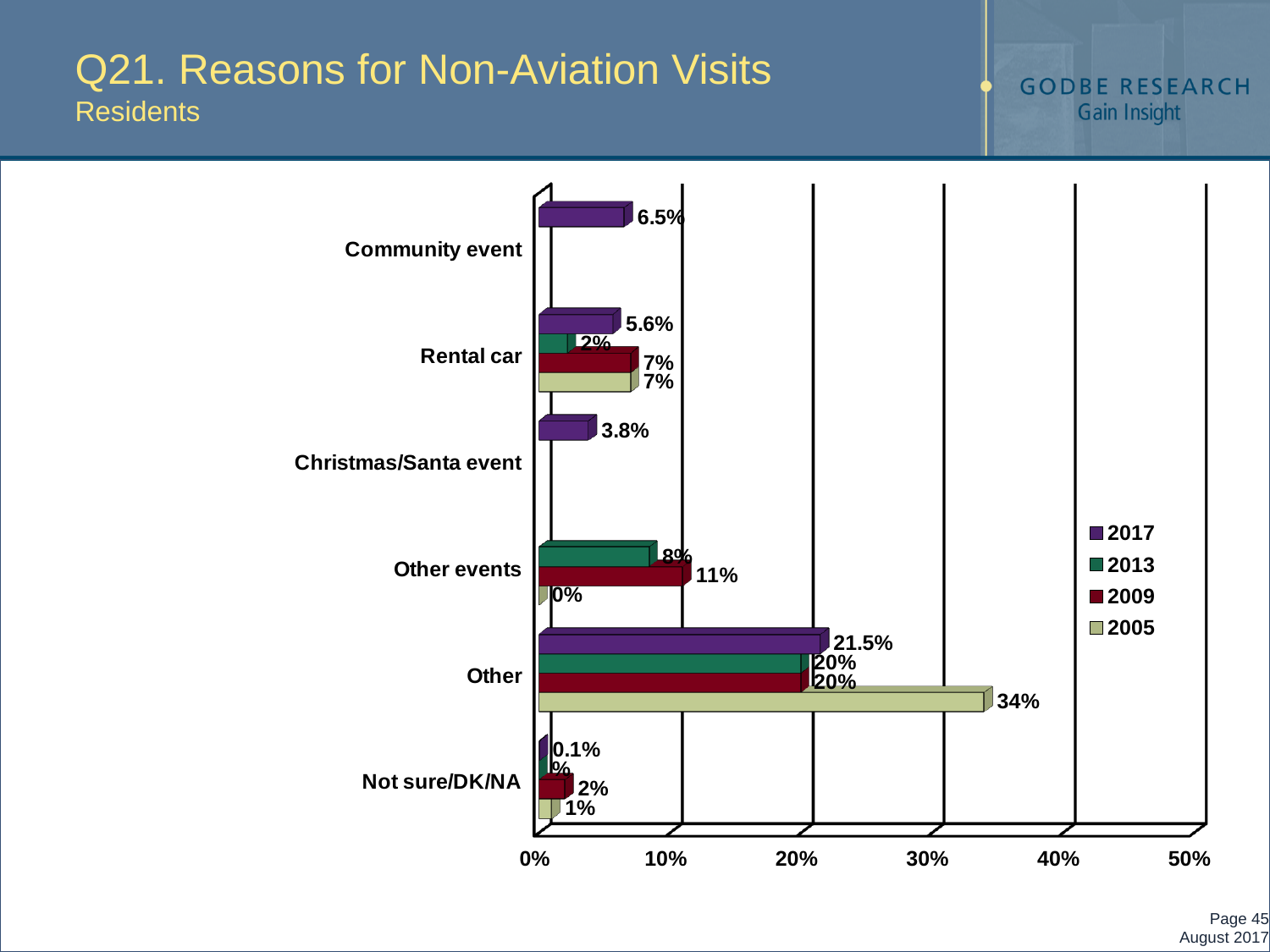
Which category has the lowest 2017 value? Not sure/DK/NA For Other events, which year has the larger value, 2009 or 2013? 2009 What is the 2017 value for Community event? 6.5% What is the 2005 value for Other? 34% How many series does the legend list? 4 What is the 2017 value for Christmas/Santa event? 3.8% What kind of chart is shown on the slide? bar chart What is the 2013 value for Rental car? 2% What is the difference between the 2005 and 2017 values for Other? 12.5% Is the 2005 value for Other greater or less than 30%? greater How many categories are shown on the chart? 6 Which category has the highest 2005 value? Other